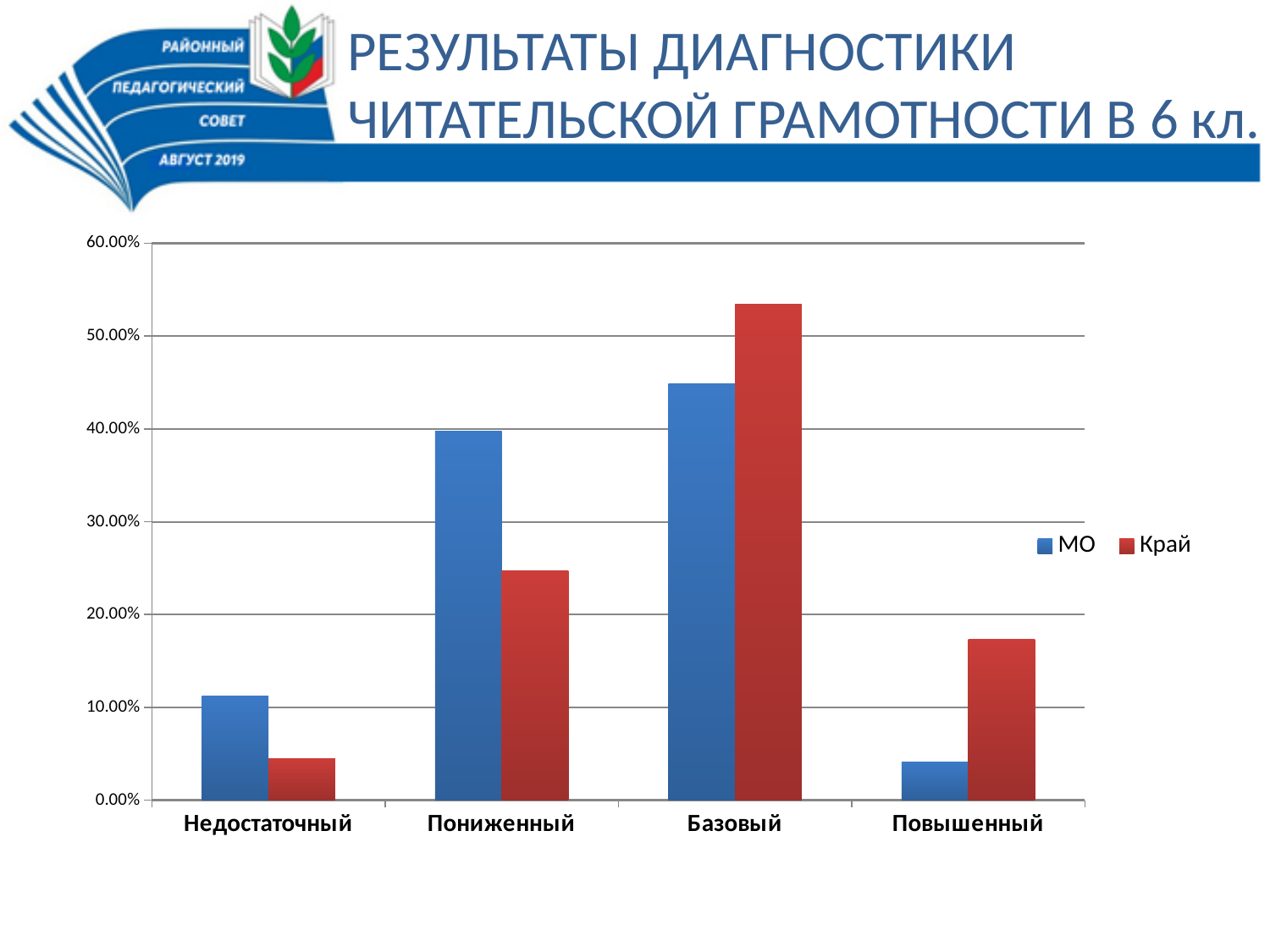
Which is larger in the Пониженный category, МО or Край? МО What kind of chart is shown on the slide? bar chart Is the value for МО in the Пониженный category greater or less than 30.00%? greater Is the value for Край in the Базовый category greater or less than 50.00%? greater Which category has the lowest value for the Край series? Недостаточный How many series does the legend list? 2 Which is larger in the Повышенный category, МО or Край? Край What colour are the bars for the Край series? red Is the value for Край in the Недостаточный category greater or less than 10.00%? less How many categories are shown on the x axis? 4 Which category has the lowest value for the МО series? Повышенный Which category has the highest value for the Край series? Базовый